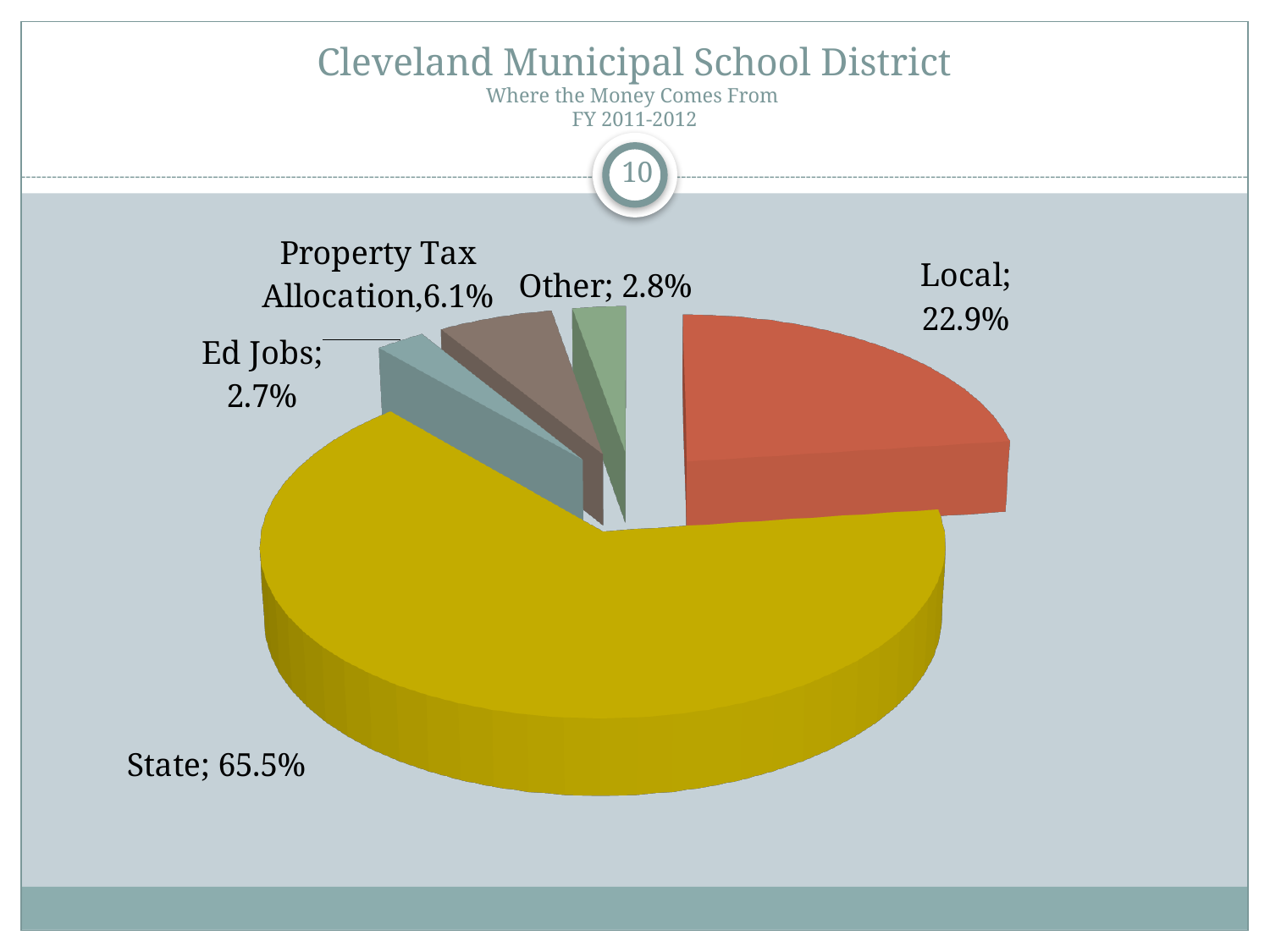
How many slices does the pie chart have? 5 What percentage is shown for Property Tax Allocation? 6.1% What percentage is shown for Ed Jobs? 2.7% What kind of chart is shown on the slide? Pie chart How many percentage points larger is the State share than the Local share? 42.6 What fiscal year does the chart cover? FY 2011-2012 Which is larger, the Local share or the Property Tax Allocation share? Local What share of the money comes from Local sources? 22.9% What percentage is shown for Other? 2.8% Which source accounts for the largest share of the money? State Which source accounts for the smallest share of the money? Ed Jobs What share of the money comes from the State? 65.5%